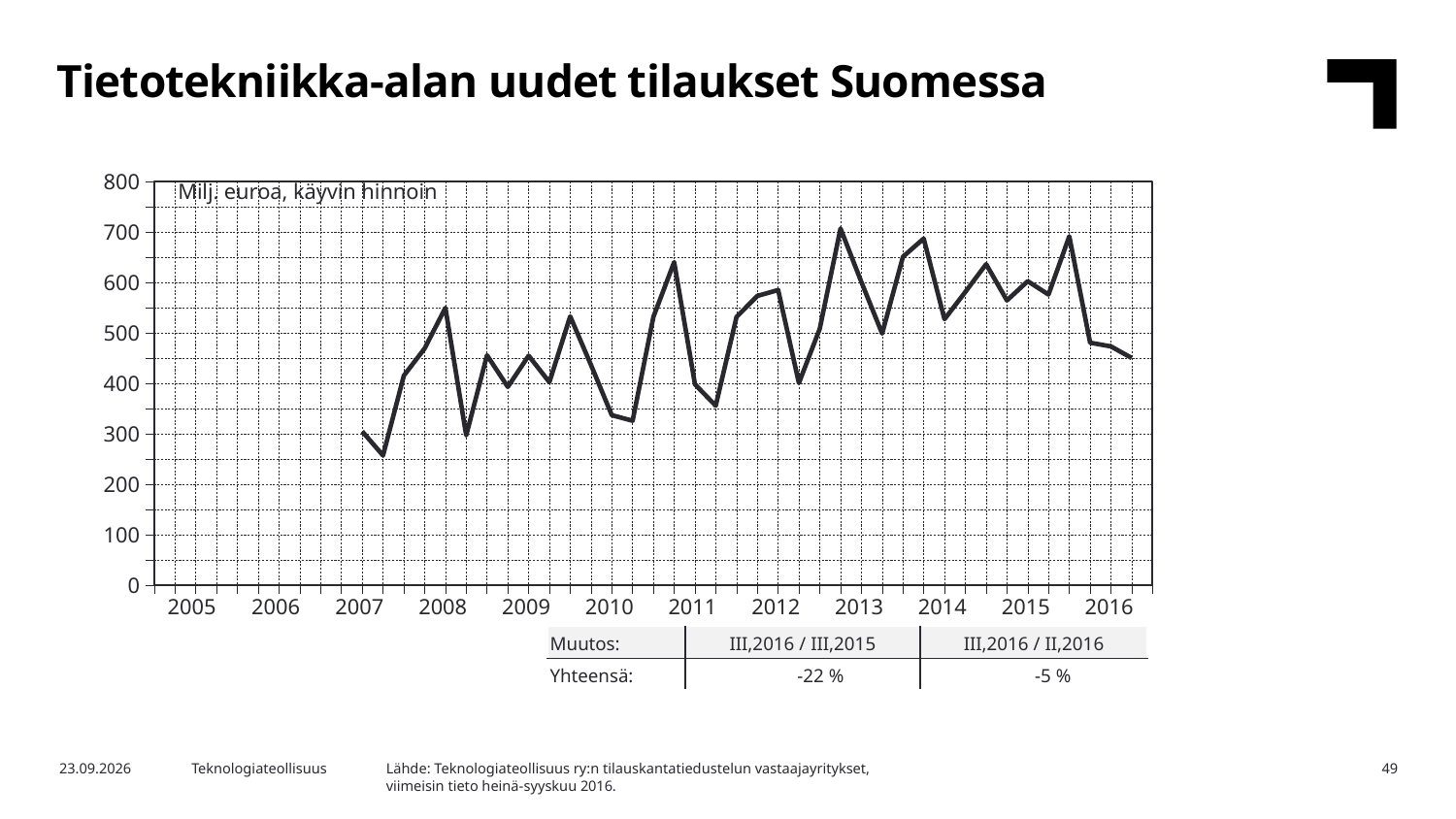
Is the value at the start of 2010 greater or less than 400? greater According to the table below the chart, what is the change for III,2016 / III,2015? -22 % Is the value at the start of 2011 greater or less than 600? greater Is the last plotted value in 2016 greater or less than 500? less What kind of chart is shown on the slide? line chart In which year does the line reach its lowest point? 2007 How many year labels are shown on the horizontal axis? 12 Does the line rise or fall from the start of 2007 to the start of 2008? rise What is the highest value shown on the vertical axis? 800 What unit is stated inside the chart area? Milj. euroa, käyvin hinnoin What is the title of the chart? Tietotekniikka-alan uudet tilaukset Suomessa